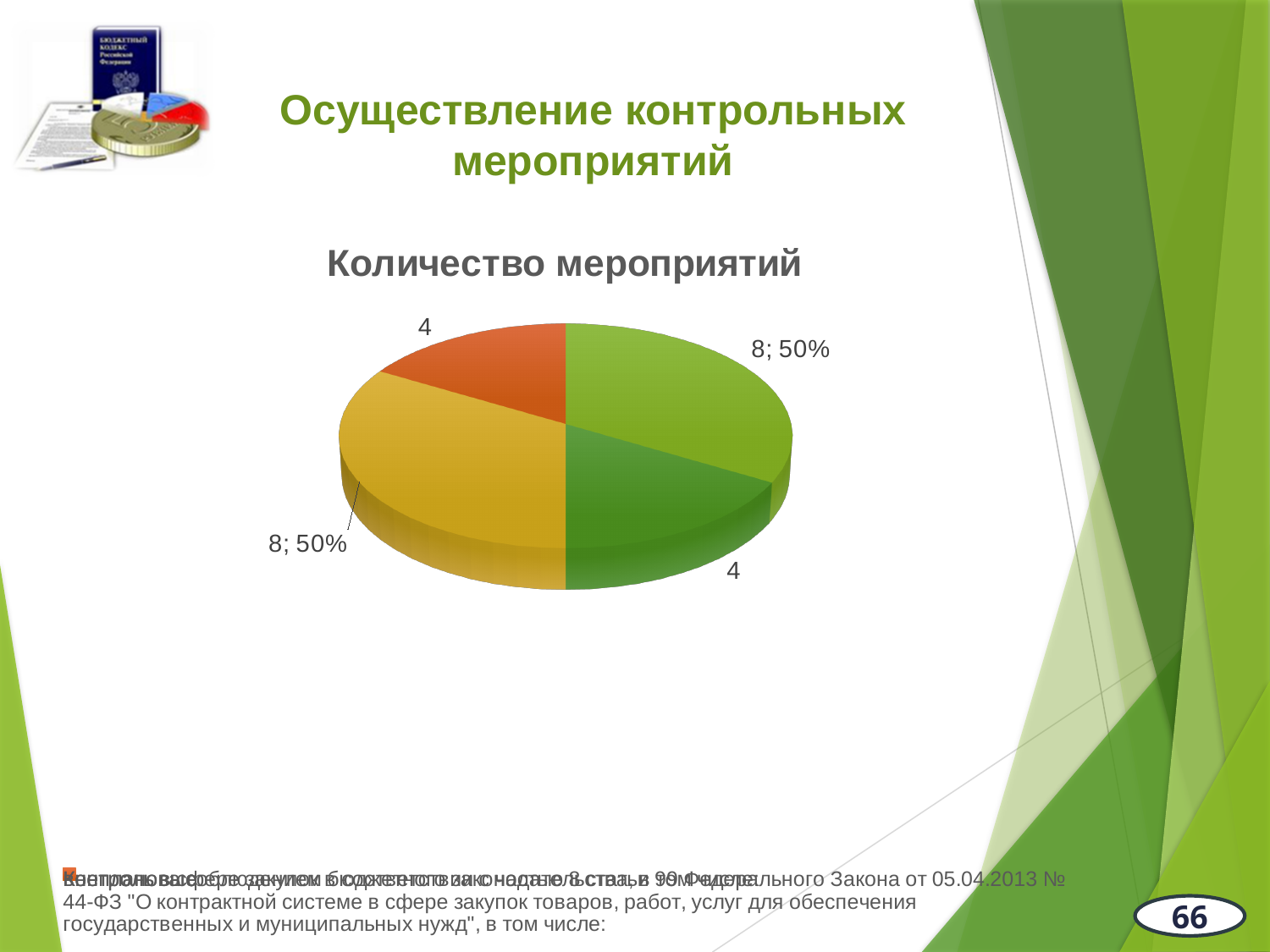
What is the difference between the value on the yellow slice and the value on the dark green slice? 4 What is the title of the chart? Количество мероприятий What value is printed on the yellow slice on the left of the pie? 8 What value is printed on the light green slice on the right of the pie? 8 What percentage share is printed for the yellow slice? 50% Which colours are used for the slices of the pie chart? light green, dark green, yellow and orange What percentage share is printed for the light green slice? 50% How many slices does the pie chart have? 4 What value is printed on the orange slice at the top left of the pie? 4 What value is printed on the dark green slice at the bottom right of the pie? 4 What kind of chart is shown on the slide? pie chart Which is larger, the value on the light green slice or the value on the orange slice? the light green slice